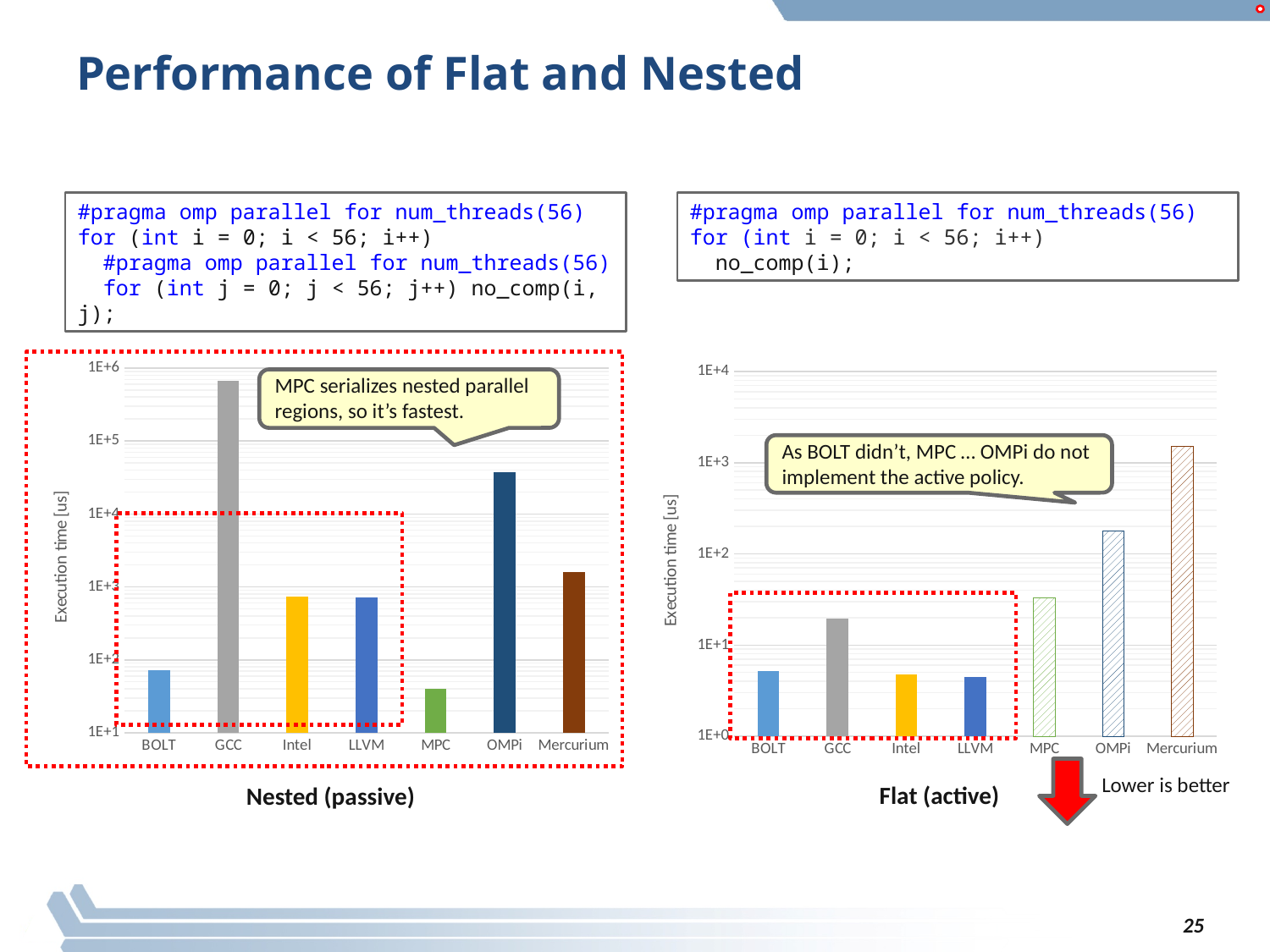
In the Flat (active) chart, is the value for OMPi greater or less than 1E+2? greater In the Nested (passive) chart, which is larger, the value for OMPi or the value for Mercurium? OMPi In the Nested (passive) chart, is the value for OMPi greater or less than 1E+4? greater In the Nested (passive) chart, which category has the lowest execution time? MPC In the Nested (passive) chart, which category has the highest execution time? GCC How many categories are shown on the x axis of the Flat (active) chart? 7 What is the y-axis label of the Flat (active) chart? Execution time [us] What kind of chart is the Nested (passive) chart? bar chart In the Flat (active) chart, which is larger, the value for MPC or the value for OMPi? OMPi In the Nested (passive) chart, is the value for GCC greater or less than 1E+5? greater In the Flat (active) chart, which category has the highest execution time? Mercurium